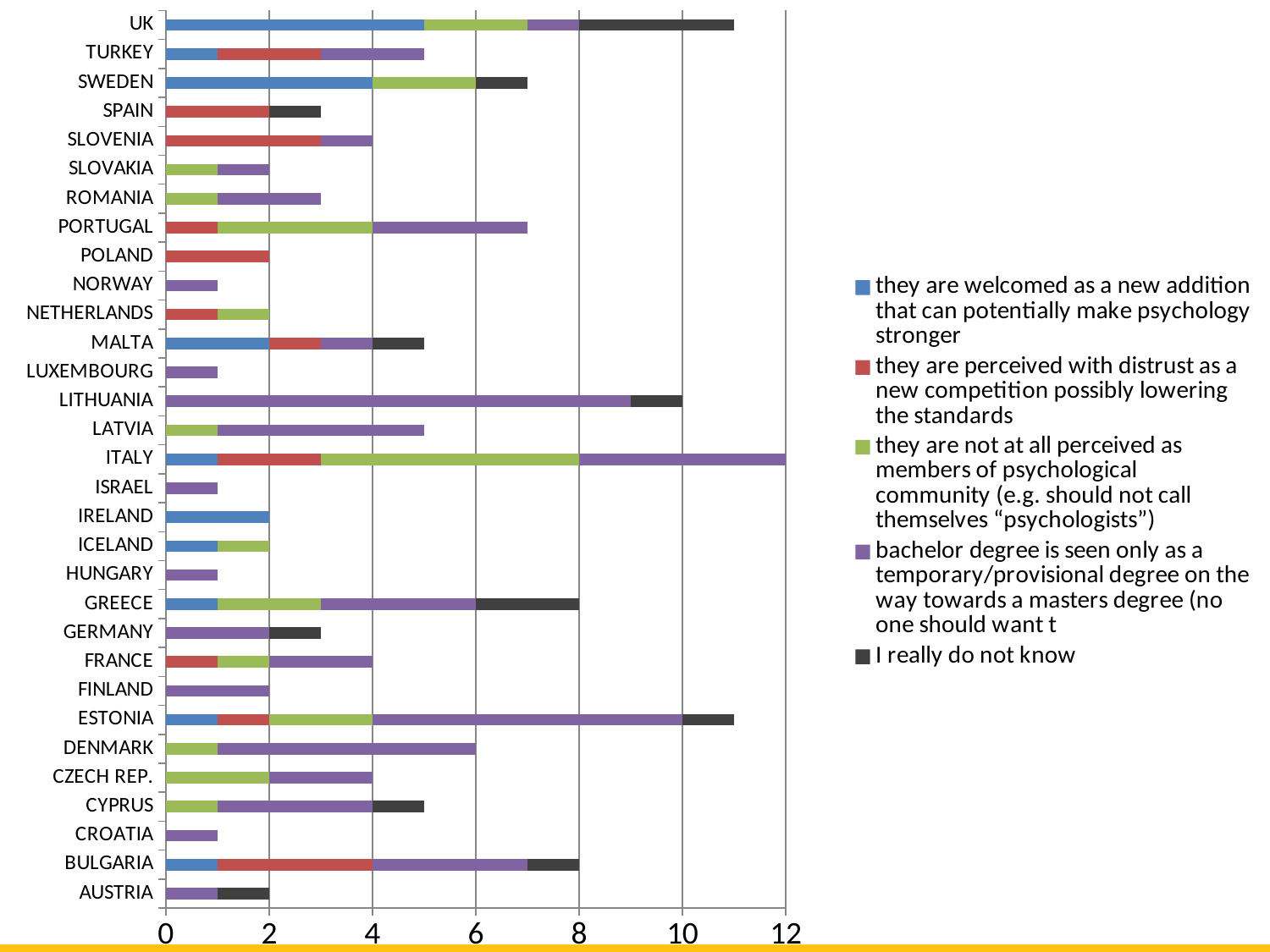
Which country has the longest total bar? ITALY Which has a longer total bar, GREECE or DENMARK? GREECE Is the total value for SWEDEN greater or less than 6? greater What is the total bar length for ITALY? 12 What is the total bar length for LITHUANIA? 10 How many series does the legend list? 5 How many countries are listed on the vertical axis of the chart? 31 What kind of chart is shown on the slide? Stacked bar chart Is the total value for UK greater or less than 10? greater What is the difference between the total bar lengths of ITALY and LITHUANIA? 2 Which legend entry is shown in dark grey? I really do not know What is the total bar length for GREECE? 8